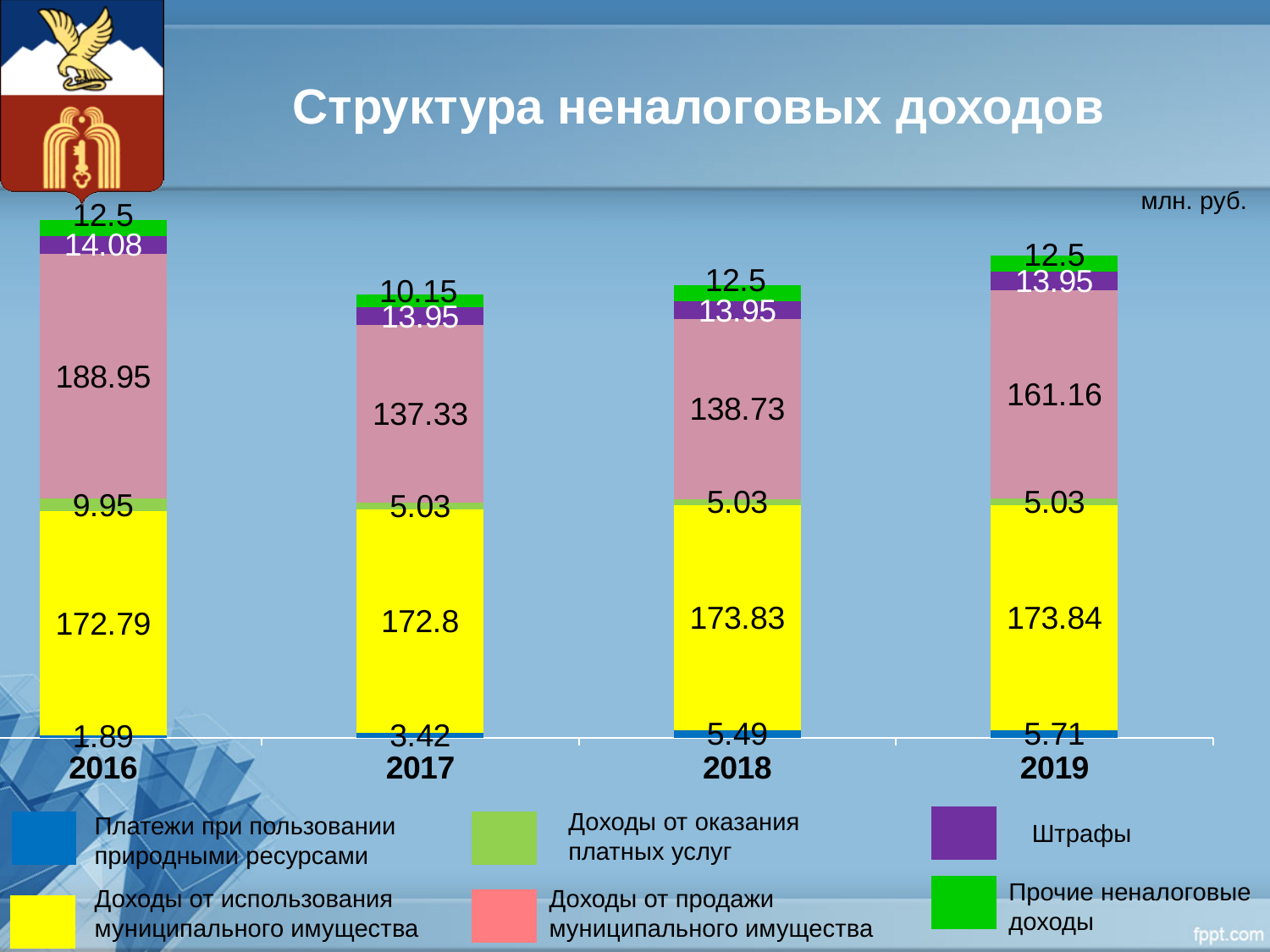
What is the value of «Прочие неналоговые доходы» in 2017? 10.15 What is the difference between «Доходы от продажи муниципального имущества» in 2016 and in 2019? 27.79 What is the value of «Доходы от продажи муниципального имущества» in 2016? 188.95 Which is larger: «Штрафы» in 2016 or «Штрафы» in 2018? 2016 In which year is «Доходы от оказания платных услуг» the highest? 2016 In which year is «Доходы от продажи муниципального имущества» the lowest? 2017 What unit of measurement is indicated on the chart? млн. руб. What is the value of «Платежи при пользовании природными ресурсами» in 2019? 5.71 How many series does the legend list? 6 What type of chart is shown on the slide? Stacked bar chart What is the value of «Доходы от использования муниципального имущества» in 2018? 173.83 What is the total of the stacked bar for 2017? 342.68